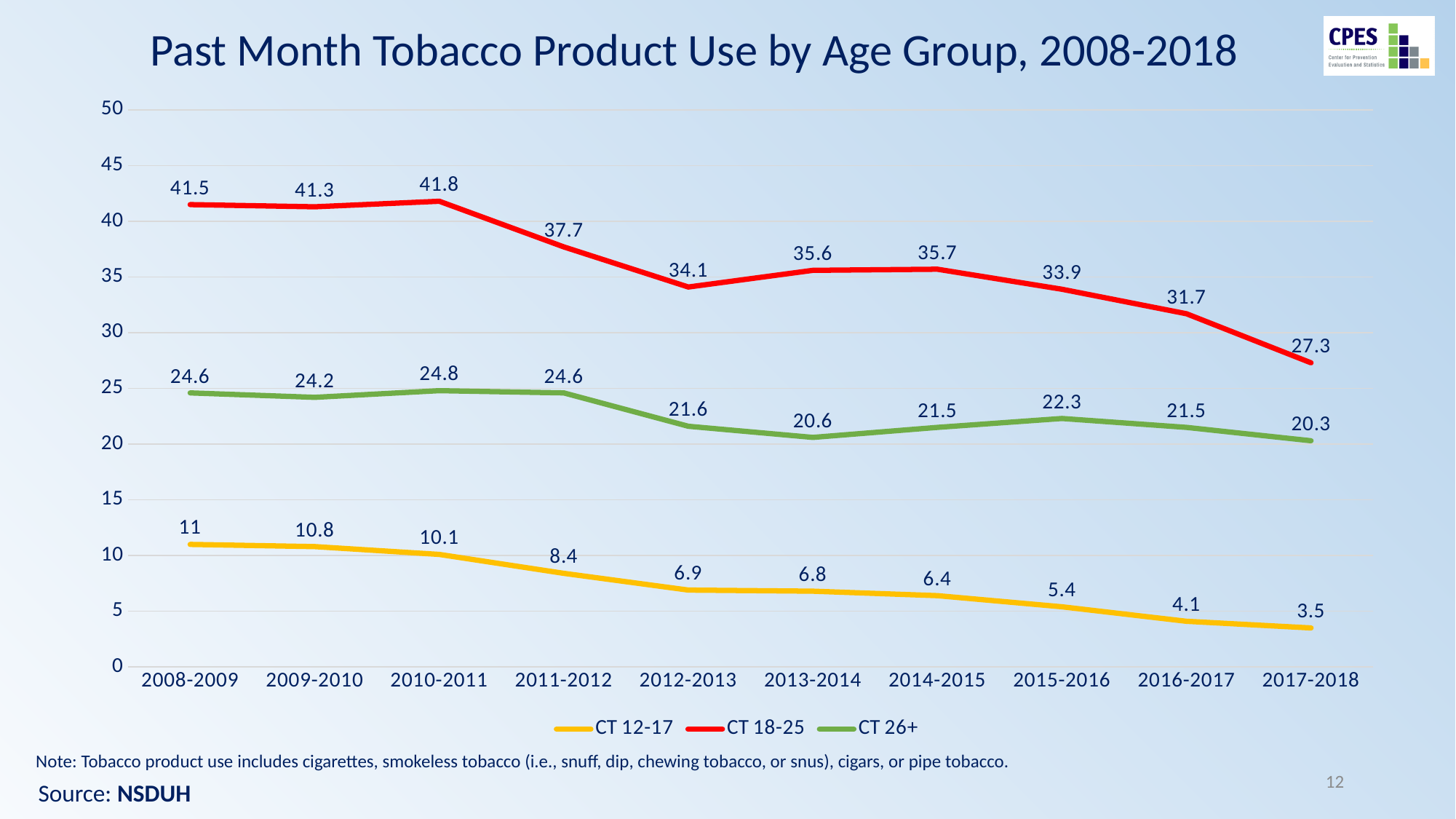
What is the value for CT 12-17 in 2017-2018? 3.5 How many series does the legend list? 3 What is the value for CT 26+ in 2013-2014? 20.6 What colour is the line for CT 18-25? red How many time periods are shown on the x axis? 10 What is the value for CT 18-25 in 2008-2009? 41.5 What kind of chart is shown on the slide? line chart Does the CT 12-17 series rise or fall from 2008-2009 to 2017-2018? fall What is the difference between the CT 18-25 value and the CT 26+ value in 2017-2018? 7 Which is larger, the CT 26+ value in 2015-2016 or in 2016-2017? 2015-2016 In which period is the CT 26+ value lowest? 2017-2018 In which period is the CT 18-25 value highest? 2010-2011